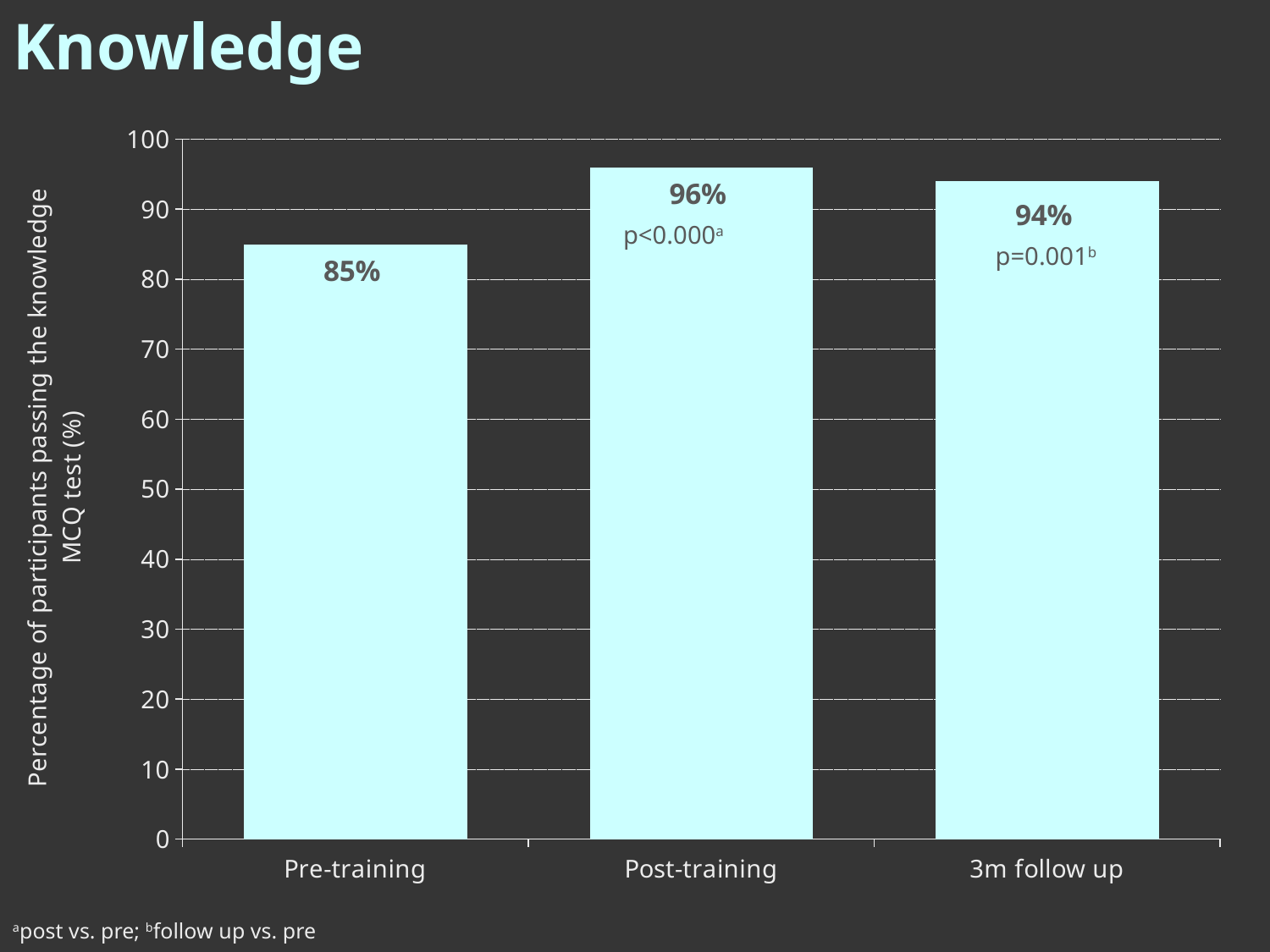
What is the difference in percentage points between 3m follow up and Pre-training? 9 What percentage of participants passed the knowledge MCQ test at 3m follow up? 94% What percentage of participants passed the knowledge MCQ test at Pre-training? 85% What percentage of participants passed the knowledge MCQ test at Post-training? 96% Is the value for Pre-training greater or less than 90? less What is the difference in percentage points between Post-training and Pre-training? 11 How many categories are shown on the x axis? 3 Which time point has the highest percentage of participants passing the test? Post-training Which is larger, the value for Post-training or the value for 3m follow up? Post-training What p-value is printed above the Post-training bar? p<0.000 Which time point has the lowest percentage of participants passing the test? Pre-training What kind of chart is shown on the slide? Bar chart